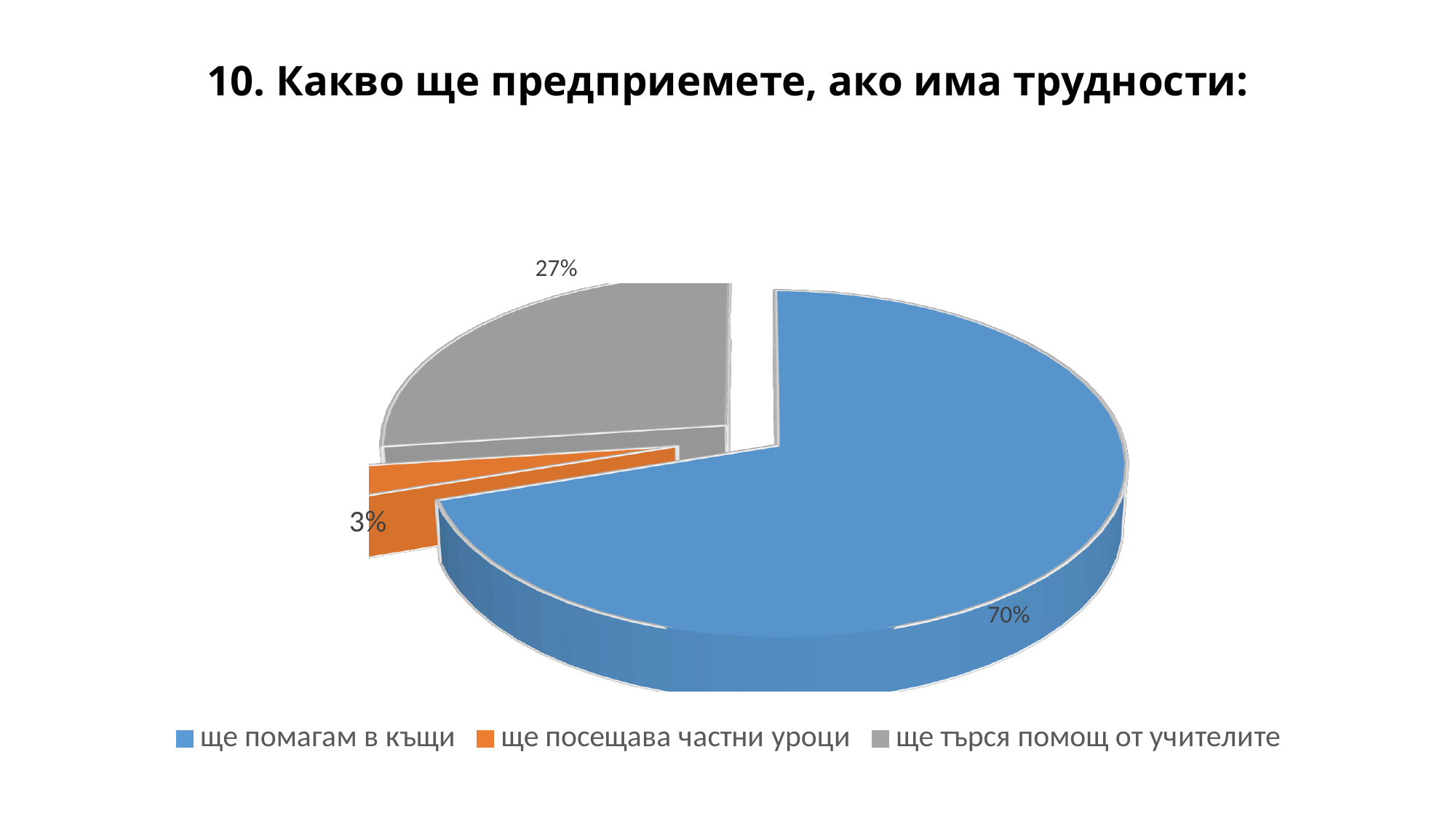
Which category has the largest slice of the pie? ще помагам в къщи What is the title of the chart? 10. Какво ще предприемете, ако има трудности: What share of the pie does "ще помагам в къщи" take? 70% What share of the pie does "ще търся помощ от учителите" take? 27% What kind of chart is shown on the slide? pie chart Which category has the smallest slice of the pie? ще посещава частни уроци What share of the pie does "ще посещава частни уроци" take? 3% Which is larger: the slice for "ще търся помощ от учителите" or the slice for "ще посещава частни уроци"? ще търся помощ от учителите What is the difference in percentage points between "ще търся помощ от учителите" and "ще посещава частни уроци"? 24 How many categories does the pie chart show? 3 What colour is the slice for "ще посещава частни уроци"? orange What is the difference in percentage points between "ще помагам в къщи" and "ще търся помощ от учителите"? 43